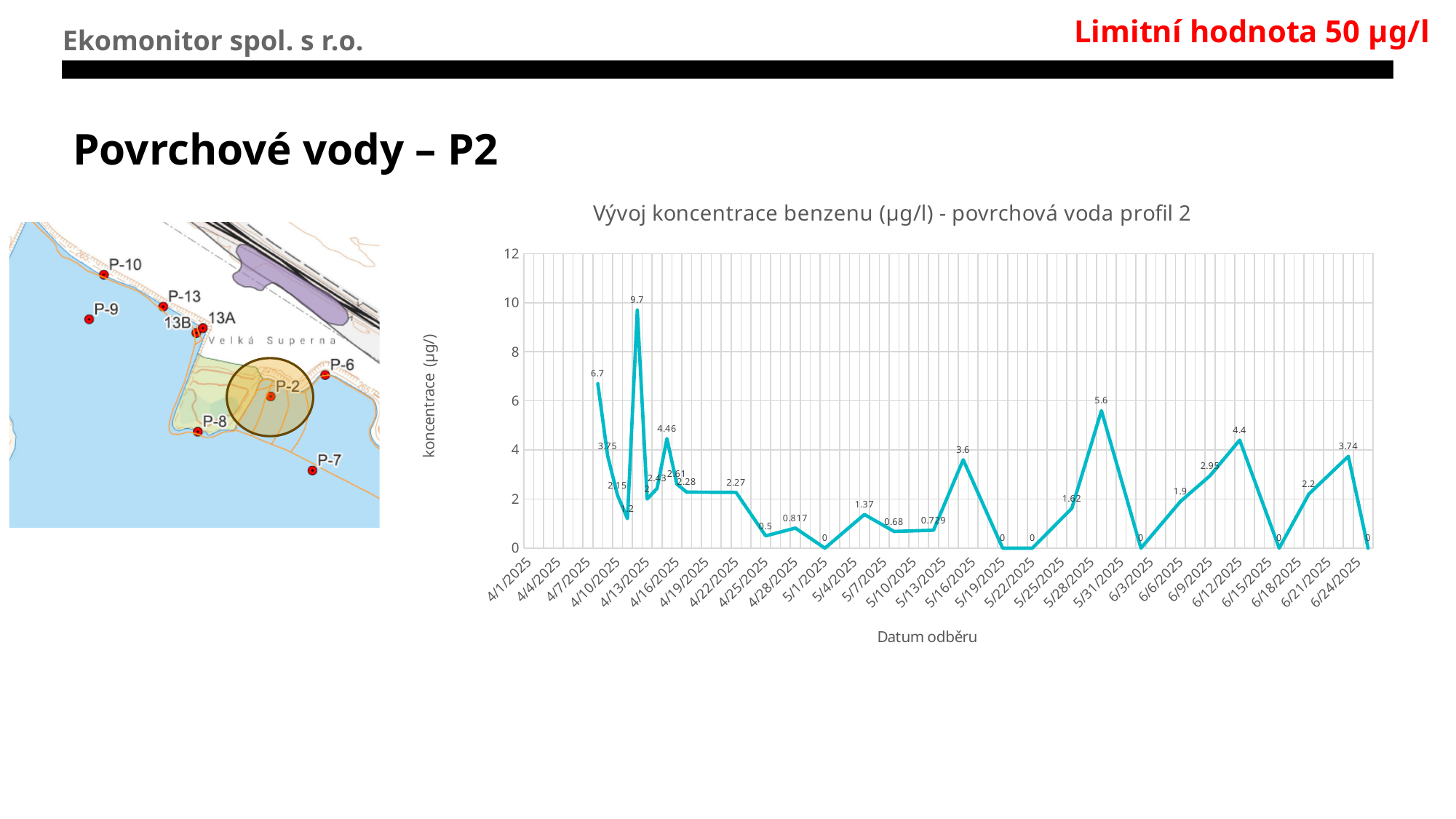
What is the highest benzene concentration value plotted on the chart? 9.7 Which is larger: the peak labelled 5.6 or the peak labelled 4.46? 5.6 What is the difference between the peaks labelled 5.6 and 4.4? 1.2 What is the value of the first data point on the chart (early April 2025)? 6.7 What is the lowest value plotted on the chart? 0 Is the highest value on the chart greater or less than 8? greater What is the title of the chart? Vývoj koncentrace benzenu (µg/l) - povrchová voda profil 2 Is the highest plotted value greater or less than the limit value of 50 µg/l stated on the slide? less What is the difference between the highest peak (9.7) and the first data point (6.7)? 3 What is the label of the y axis? koncentrace (µg/l) What is the value of the peak that occurs around 4/13/2025? 9.7 What kind of chart is shown on the slide? line chart